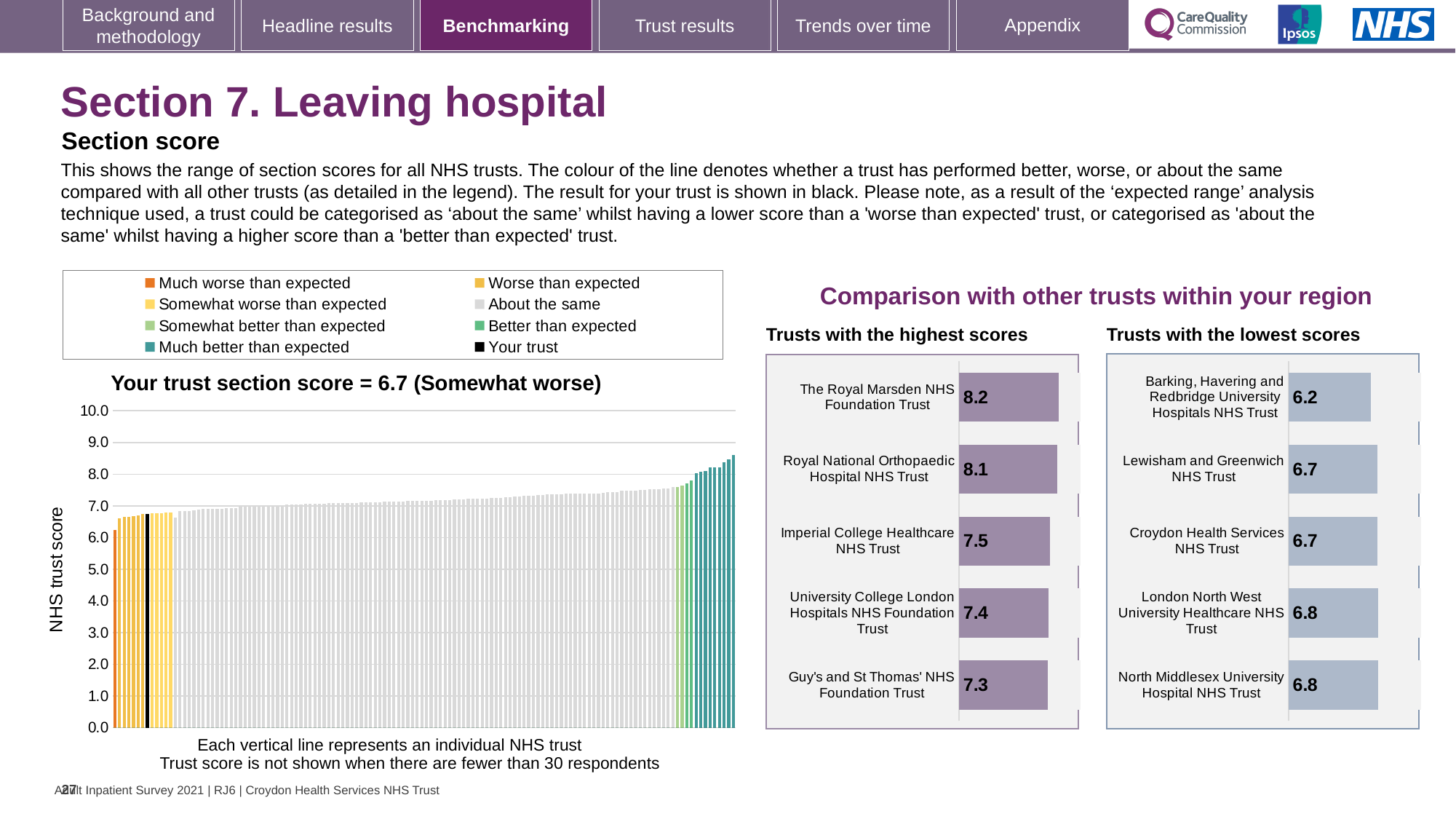
In the 'Trusts with the highest scores' chart, what is the difference between the scores of The Royal Marsden NHS Foundation Trust and Guy's and St Thomas' NHS Foundation Trust? 0.9 In the 'Trusts with the highest scores' chart, what is the score for Imperial College Healthcare NHS Trust? 7.5 In the main chart on the left, what is your trust's section score? 6.7 In the 'Trusts with the highest scores' chart, which trust has the lowest score shown? Guy's and St Thomas' NHS Foundation Trust In the 'Trusts with the lowest scores' chart, which trust has the lowest score? Barking, Havering and Redbridge University Hospitals NHS Trust In the 'Trusts with the lowest scores' chart, which has the larger score: Barking, Havering and Redbridge University Hospitals NHS Trust or Lewisham and Greenwich NHS Trust? Lewisham and Greenwich NHS Trust In the main chart on the left, do the trust scores rise or fall from left to right along the x axis? Rise In the 'Trusts with the lowest scores' chart, what is the score for Barking, Havering and Redbridge University Hospitals NHS Trust? 6.2 In the 'Trusts with the highest scores' chart, what is the score for The Royal Marsden NHS Foundation Trust? 8.2 What kind of chart is the main chart on the left showing NHS trust scores? Bar chart In the 'Trusts with the lowest scores' chart, what is the score for London North West University Healthcare NHS Trust? 6.8 In the 'Trusts with the highest scores' chart, how many trusts are shown? 5